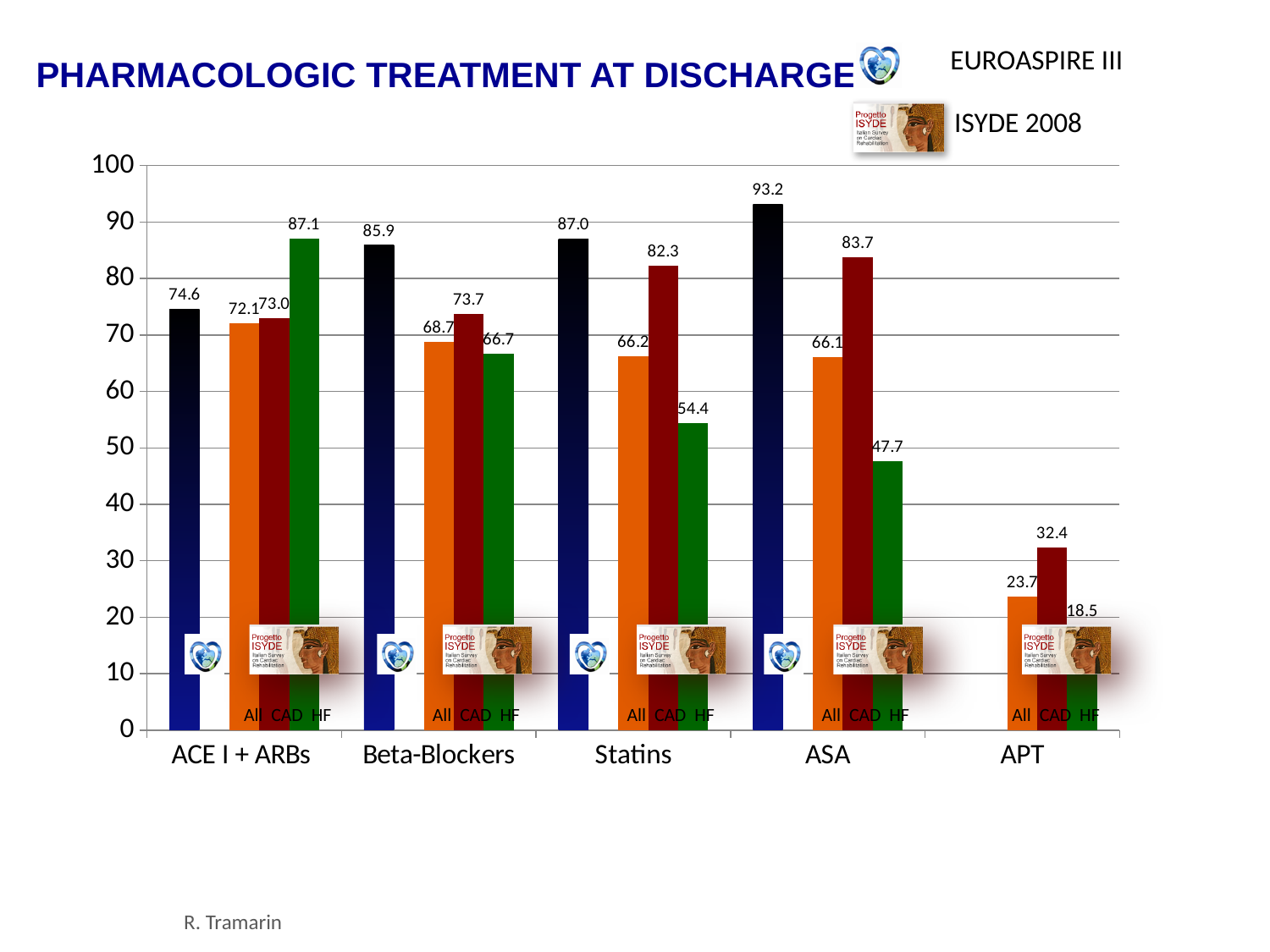
For ASA, what is the difference between the EUROASPIRE III value and the ISYDE 'All' value? 27.1 What is the ISYDE 'All' value for Beta-Blockers? 68.7 Which treatment category has the highest EUROASPIRE III value? ASA For ACE I + ARBs, which is larger: the HF value or the EUROASPIRE III value? HF How many treatment categories are shown on the x axis? 5 What is the EUROASPIRE III value for ASA? 93.2 What is the HF value for Statins? 54.4 For Statins, what is the difference between the CAD value and the 'All' value? 16.1 Which treatment category has the lowest HF value? APT Is the HF value for ASA greater or less than 50? less What type of chart is shown on the slide? bar chart What is the CAD value for APT? 32.4